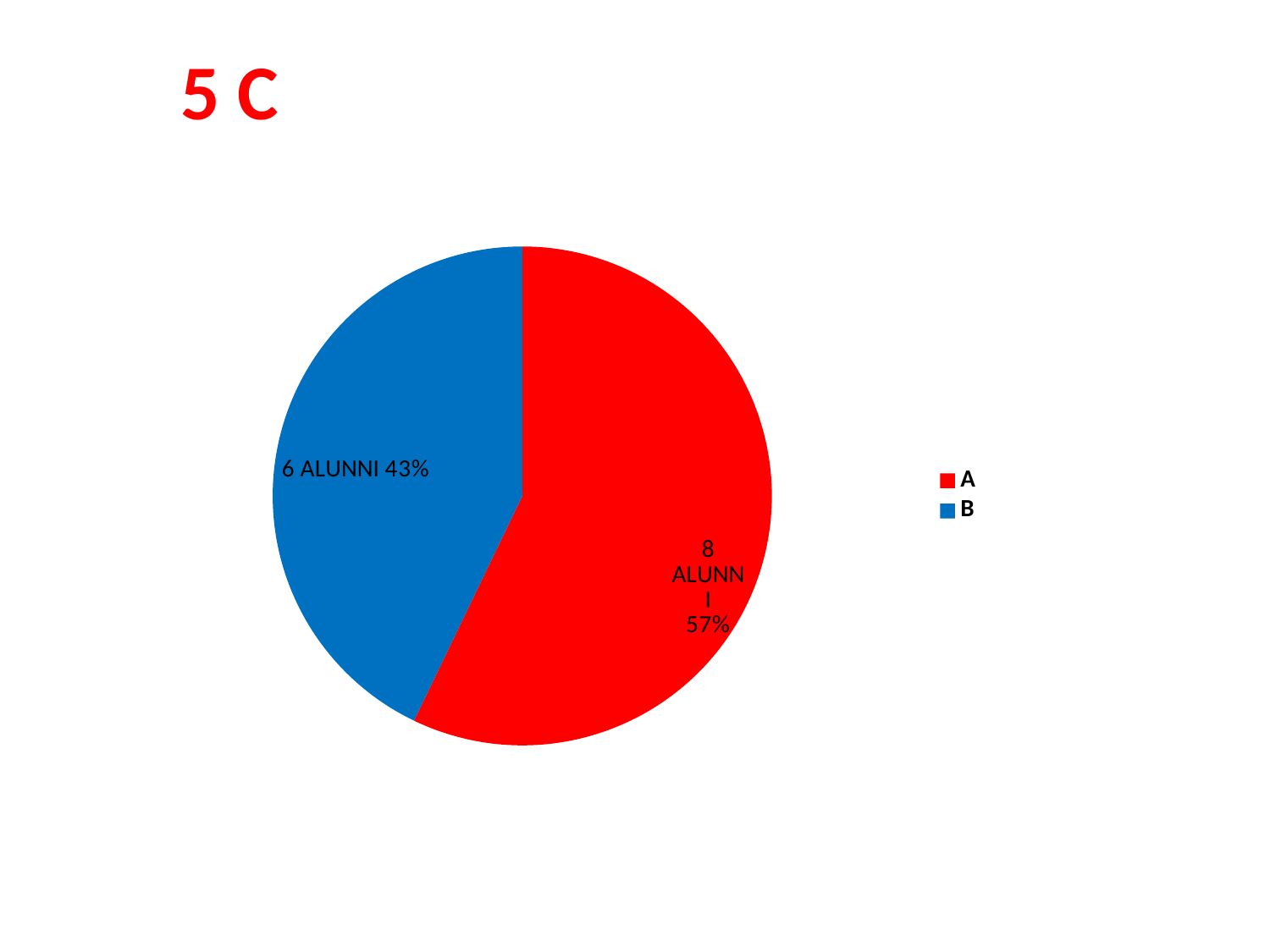
What percentage share does slice B have? 43% How many alunni are in category B? 6 ALUNNI What kind of chart is shown on the slide? pie chart What colour is the slice for category B? blue What percentage share does slice A have? 57% Which category has the largest slice? A How many entries does the legend list? 2 How many alunni are in category A? 8 ALUNNI Which is larger, the slice for A or the slice for B? A How many slices does the pie chart have? 2 What is the difference in percentage points between slice A and slice B? 14 Which category has the smallest slice? B